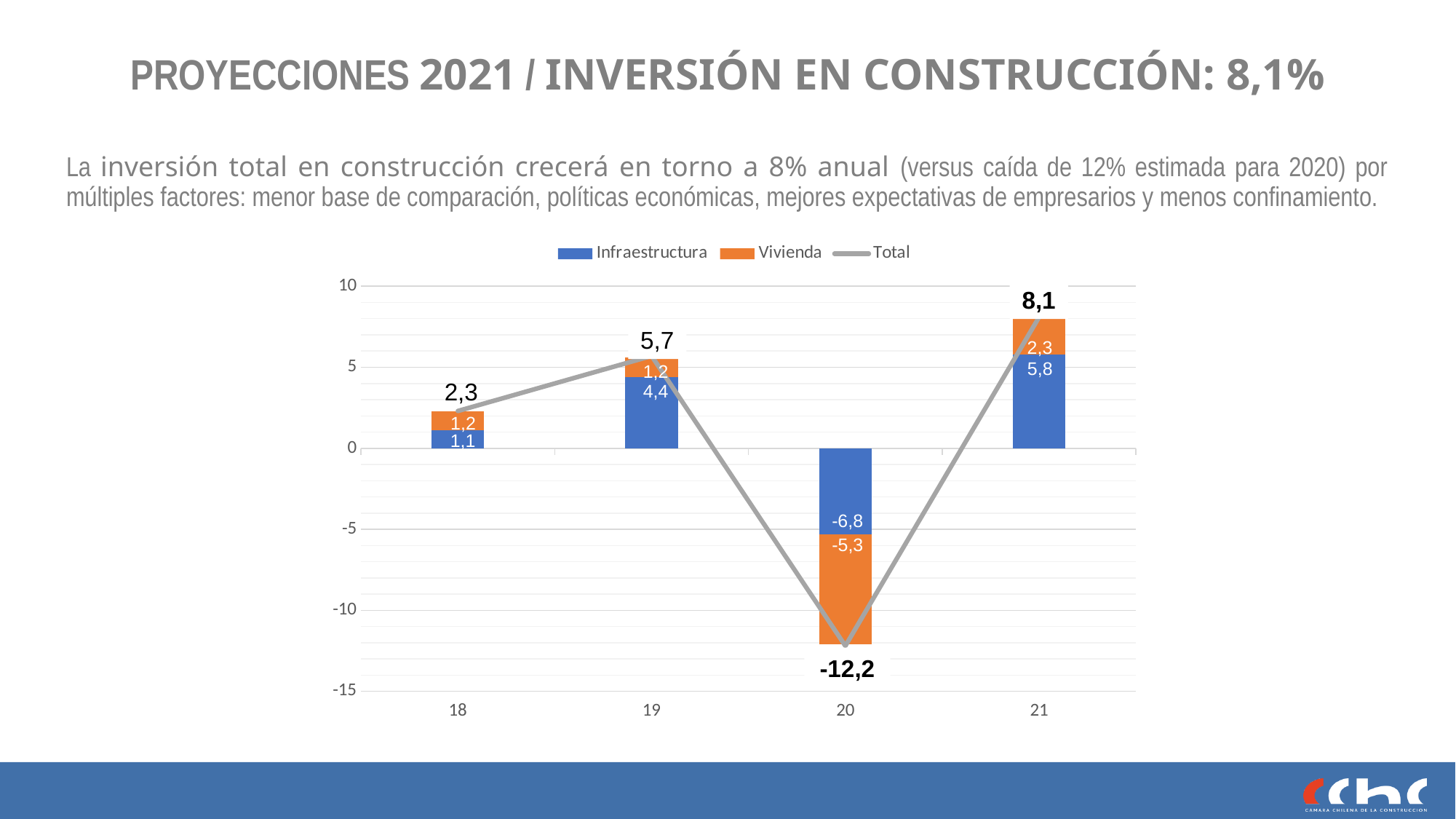
Which year has the highest Total value? 21 How many series does the legend list? 3 Which series is drawn as a grey line? Total What is the Total value for 19? 5,7 Is the Total value for 20 greater or less than -10? less How many years are shown on the x axis? 4 What is the Infraestructura value for 18? 1,1 Which is larger, the Infraestructura value for 19 or the Infraestructura value for 21? 21 What is the Infraestructura value for 21? 5,8 Which year has the lowest Total value? 20 What is the difference between the Total values for 21 and 19? 2,4